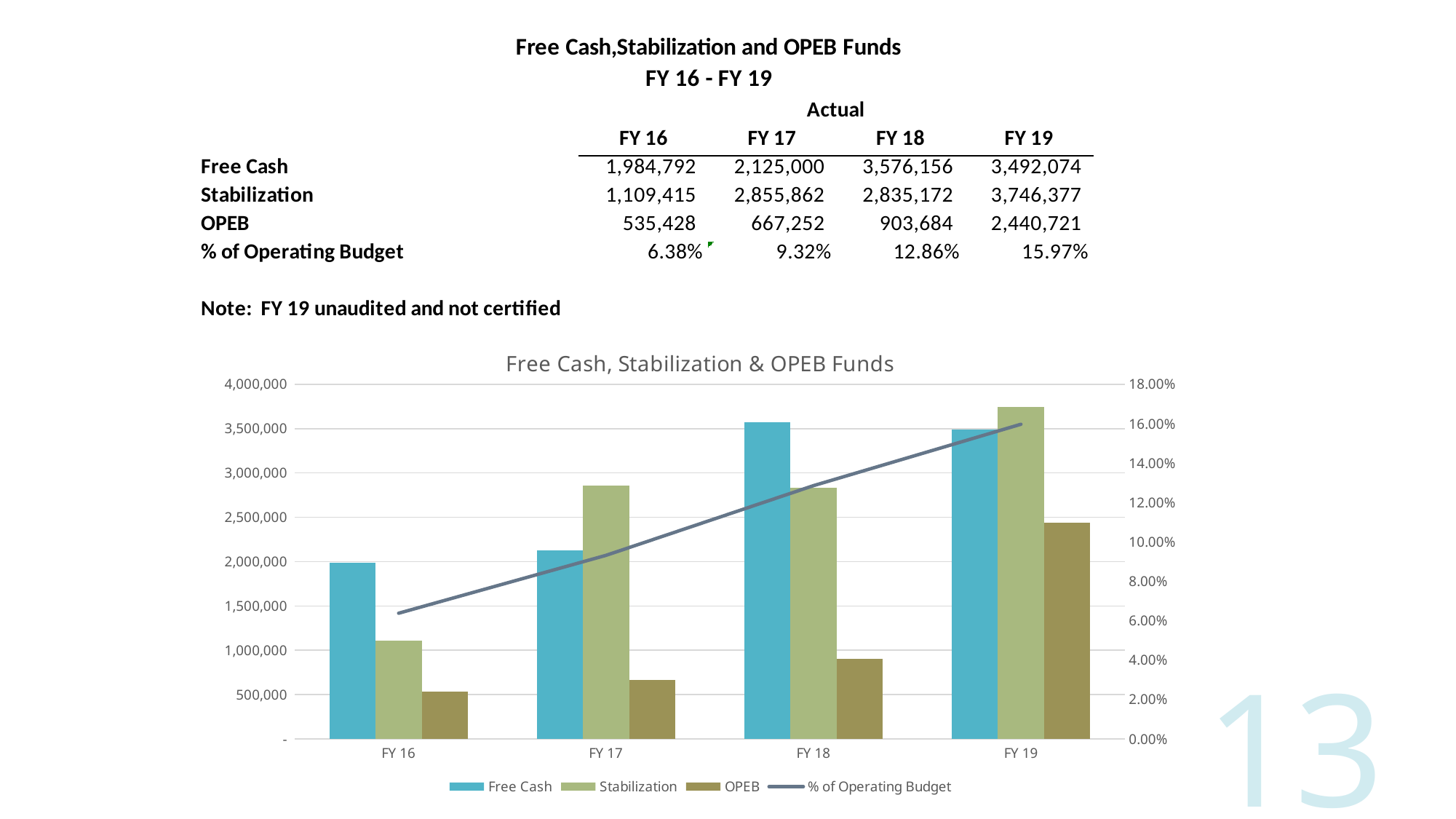
What kind of chart is shown on the slide? Bar chart with a line What is the % of Operating Budget for FY 17? 9.32% Which is larger in FY 17, Free Cash or Stabilization? Stabilization What is the difference between Stabilization and Free Cash in FY 19? 254,303 How many fiscal years are shown on the x axis of the chart? 4 What is the OPEB value for FY 19? 2,440,721 Is the Free Cash bar for FY 16 greater or less than 1,500,000? greater In which fiscal year is OPEB lowest? FY 16 What is the Free Cash value for FY 18? 3,576,156 Does the % of Operating Budget rise or fall from FY 16 to FY 19? Rise How many series does the chart legend list? 4 In which fiscal year is Stabilization highest? FY 19